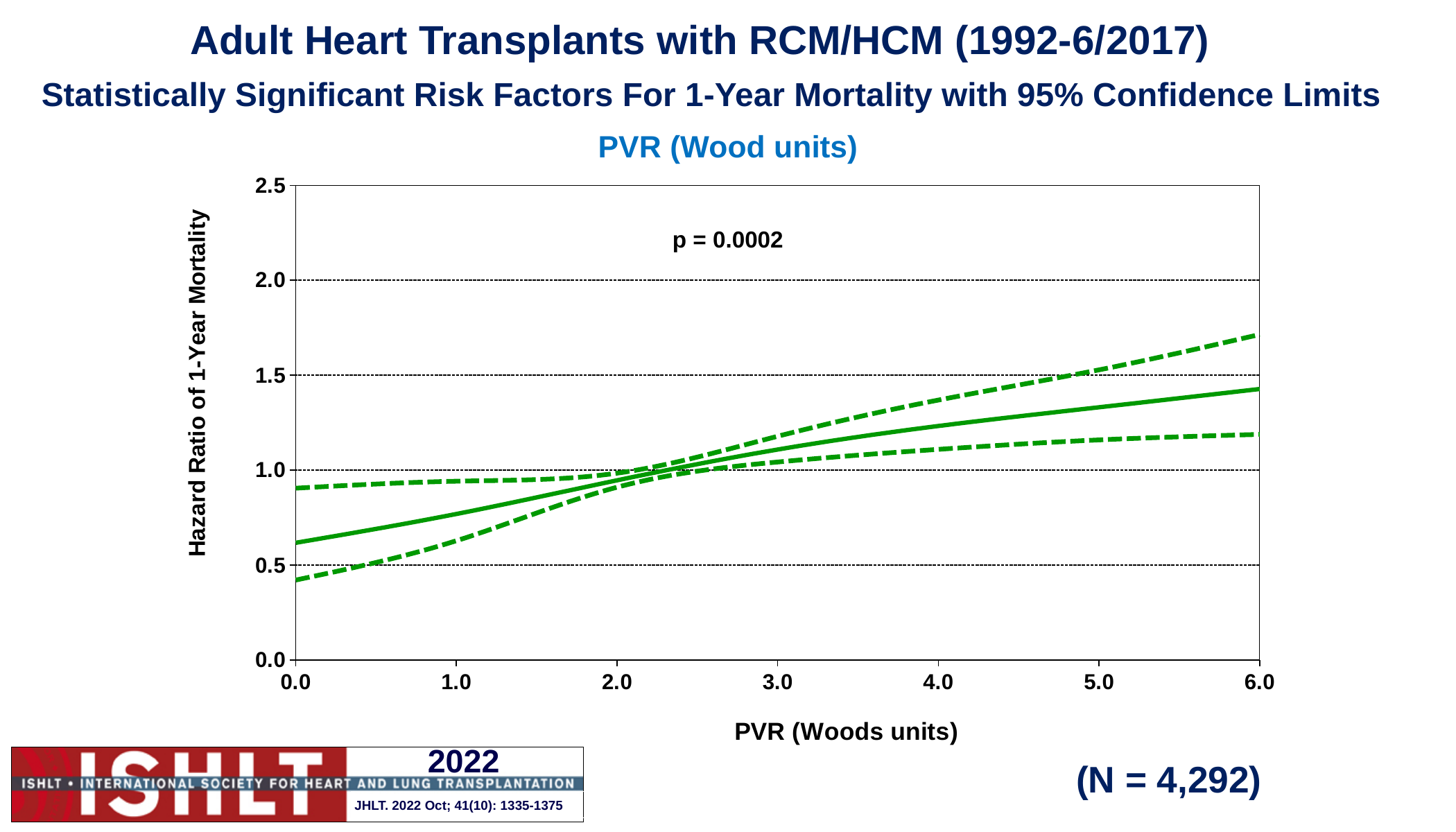
Is the upper dashed confidence limit at a PVR of 6.0 greater or less than 1.5? greater Is the hazard ratio on the solid line at a PVR of 0.0 greater or less than 0.5? greater Is the hazard ratio on the solid line at a PVR of 6.0 greater or less than 1.5? less What p-value is printed on the chart? p = 0.0002 Does the solid hazard ratio line rise or fall as PVR increases from 0.0 to 6.0 Wood units? rise Is the hazard ratio on the solid line higher at a PVR of 6.0 or at a PVR of 0.0? 6.0 How many lines are plotted on the chart? 3 What is the label of the y-axis? Hazard Ratio of 1-Year Mortality What kind of chart is shown on the slide? line chart